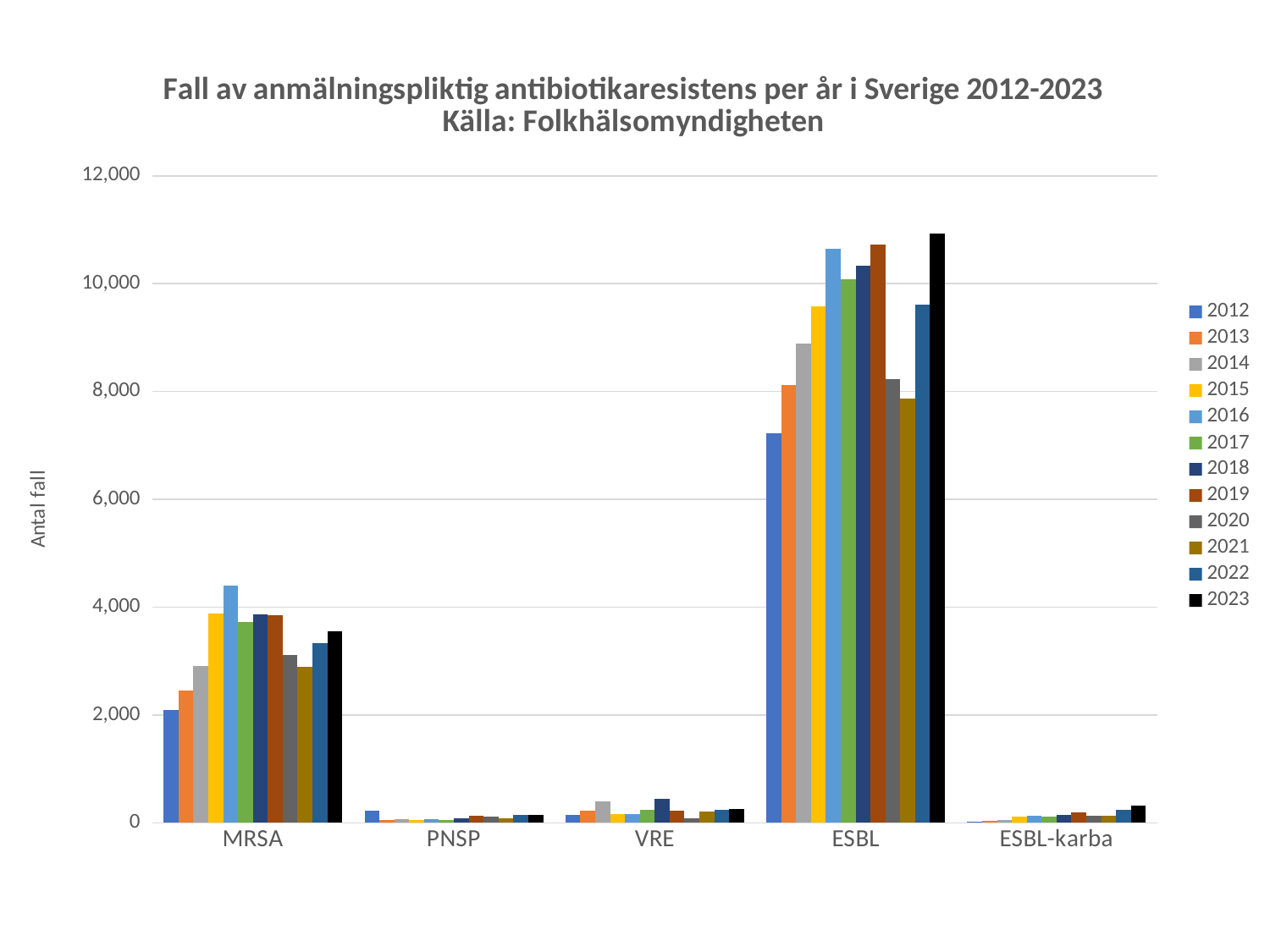
Which category has the highest values overall? ESBL How many series does the legend list? 12 How many categories are shown on the x axis? 5 Is the value for ESBL in 2012 greater or less than 8,000? less Which year has the highest value for MRSA? 2016 Which year has the lowest value for ESBL? 2012 Is the value for MRSA in 2016 greater or less than 4,000? greater Which is larger, the value for MRSA in 2012 or in 2016? 2016 What is the label of the y axis? Antal fall Which is larger, the value for ESBL in 2012 or in 2013? 2013 Is the value for ESBL in 2023 greater or less than 10,000? greater What kind of chart is shown on the slide? bar chart